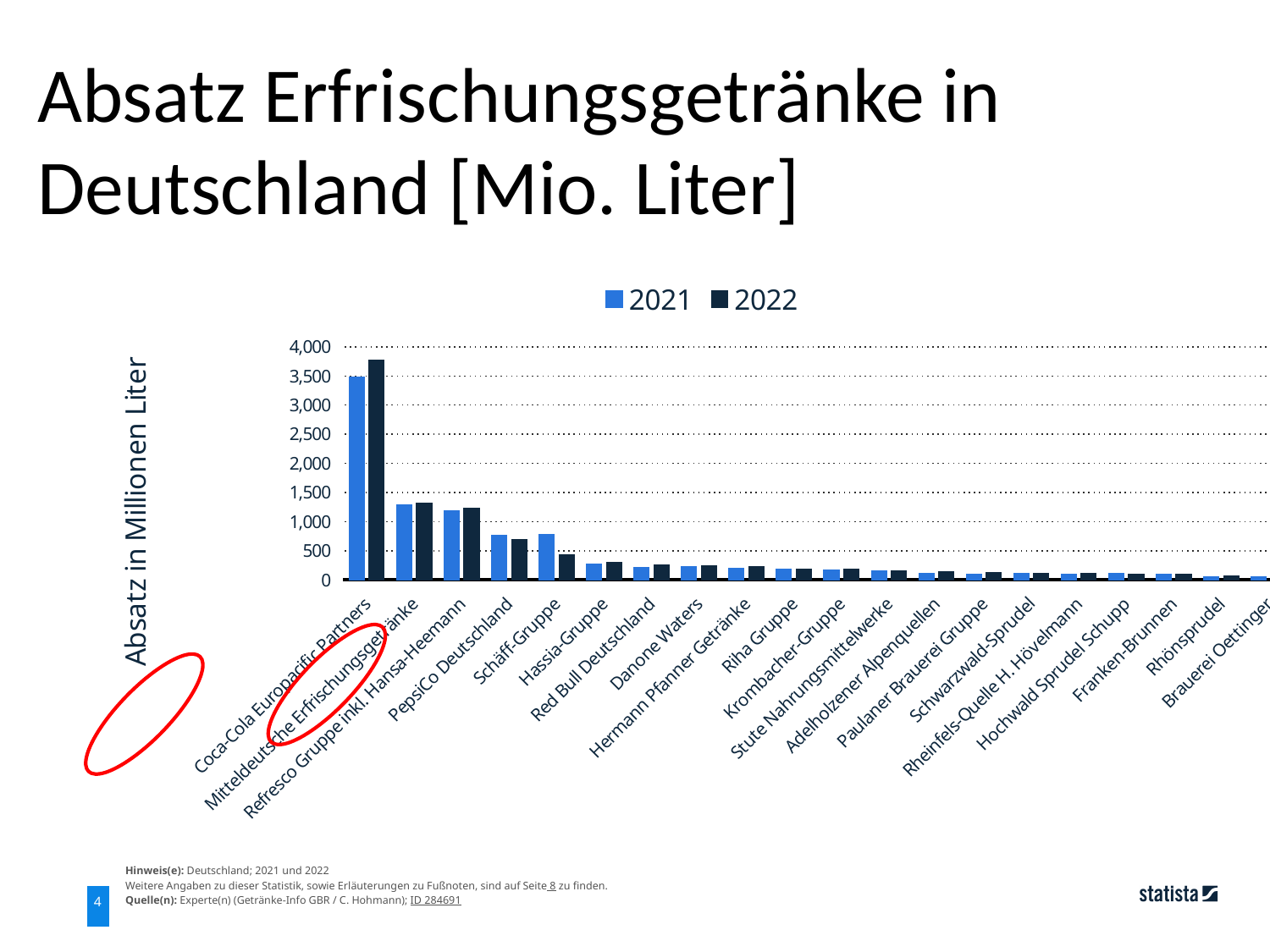
For Schäff-Gruppe, which year has the larger value, 2021 or 2022? 2021 What is the label of the vertical axis? Absatz in Millionen Liter Which company has the highest sales value in 2022? Coca-Cola Europacific Partners Is the 2021 value for Mitteldeutsche Erfrischungsgetränke greater or less than 1,000? greater Which company has the highest sales value in 2021? Coca-Cola Europacific Partners What kind of chart is shown on the slide? bar chart Is the 2021 value for PepsiCo Deutschland greater or less than 500? greater How many series does the legend list? 2 For Coca-Cola Europacific Partners, which year has the larger value, 2021 or 2022? 2022 Is the 2022 value for Coca-Cola Europacific Partners greater or less than 3,500? greater Do the values generally rise or fall moving from left to right along the x axis? fall